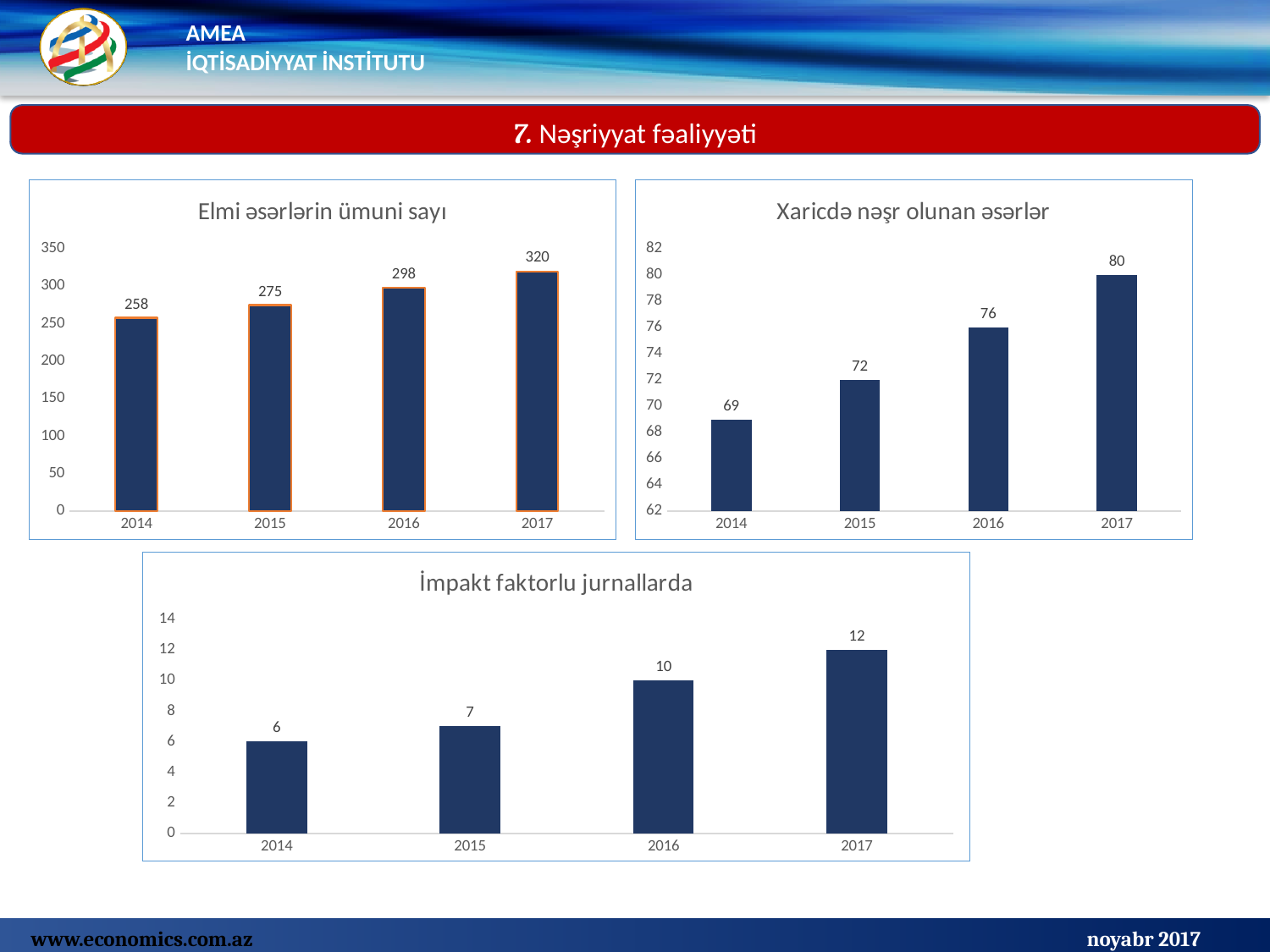
In the chart titled 'Elmi əsərlərin ümuni sayı', what is the value for 2016? 298 In the chart titled 'Xaricdə nəşr olunan əsərlər', which year has the lowest value? 2014 In the chart titled 'Xaricdə nəşr olunan əsərlər', what is the value for 2015? 72 In the chart titled 'Elmi əsərlərin ümuni sayı', what is the difference between the values for 2017 and 2014? 62 In the chart titled 'İmpakt faktorlu jurnallarda', which is larger, the value for 2015 or the value for 2016? 2016 In the chart titled 'İmpakt faktorlu jurnallarda', what is the value for 2017? 12 In the chart titled 'Xaricdə nəşr olunan əsərlər', do the values rise or fall from 2014 to 2017? rise In the chart titled 'İmpakt faktorlu jurnallarda', how many years are shown on the x axis? 4 In the chart titled 'Elmi əsərlərin ümuni sayı', which year has the highest value? 2017 What kind of chart is the chart titled 'İmpakt faktorlu jurnallarda'? bar chart How many charts are shown on the slide? 3 In the chart titled 'Xaricdə nəşr olunan əsərlər', what is the difference between the values for 2016 and 2015? 4